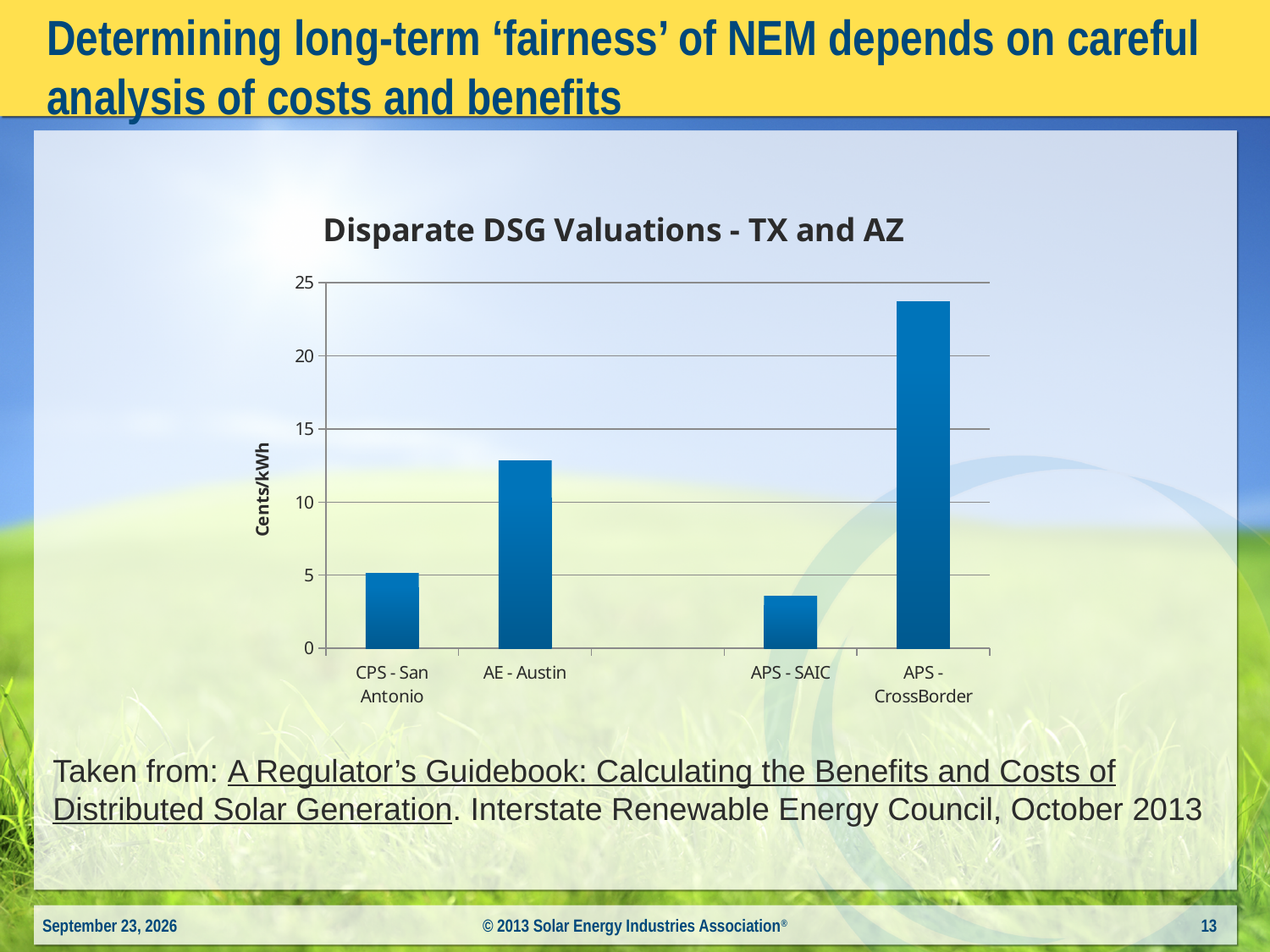
What is the title of the chart? Disparate DSG Valuations - TX and AZ Which category has the highest value in the chart? APS - CrossBorder Is the value for AE - Austin greater or less than 10? greater What kind of chart is shown on the slide? bar chart Is the value for APS - CrossBorder greater or less than 20? greater How many categories (bars) are plotted in the chart? 4 Which has a larger value, AE - Austin or CPS - San Antonio? AE - Austin Is the value for AE - Austin greater or less than 15? less Which category has the lowest value in the chart? APS - SAIC What is the label on the vertical axis of the chart? Cents/kWh